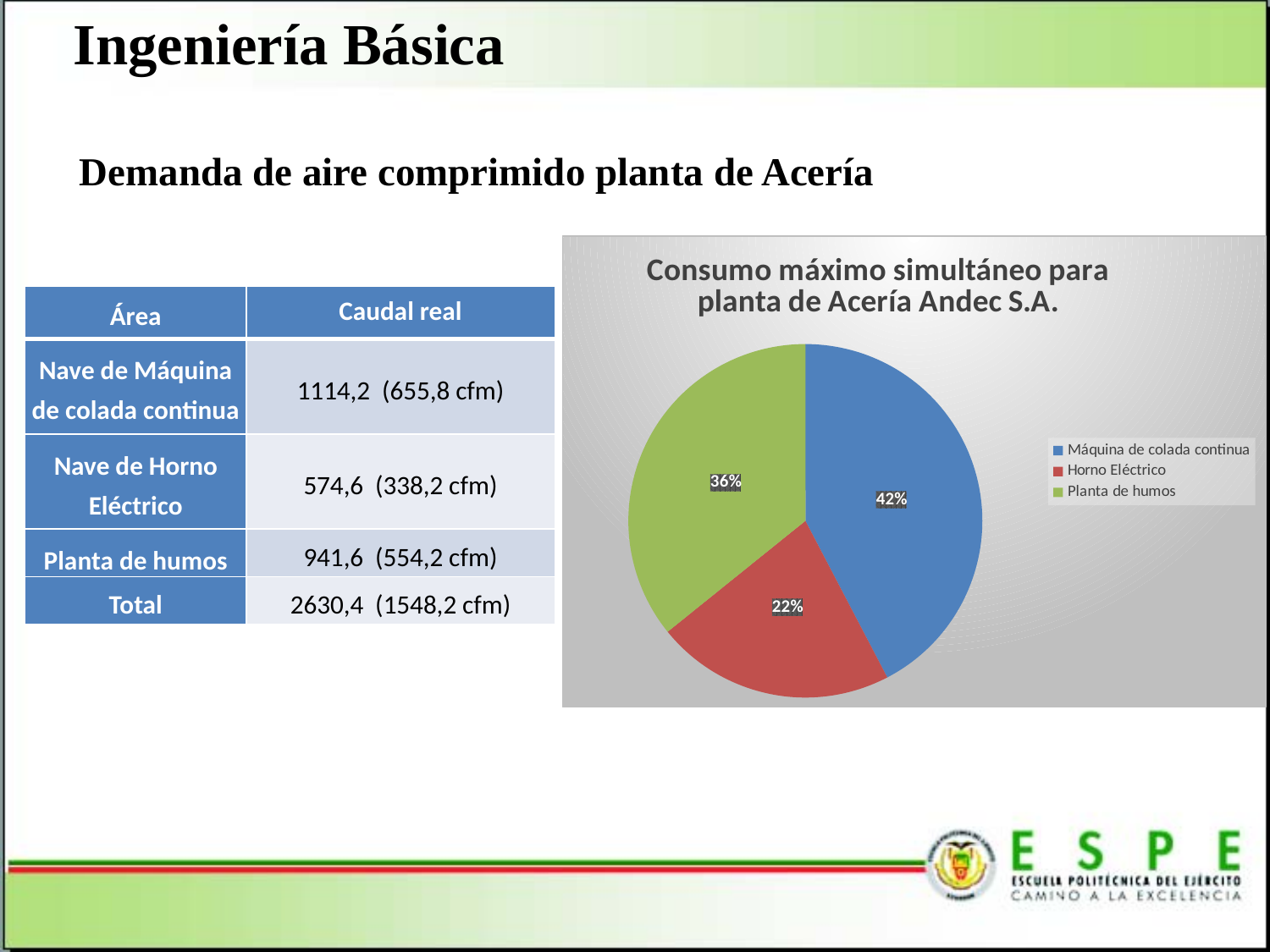
What share of the pie does Planta de humos represent? 36% What kind of chart is shown on the slide? pie chart What is the title of the chart? Consumo máximo simultáneo para planta de Acería Andec S.A. How many slices does the pie chart have? 3 What share of the pie does Horno Eléctrico represent? 22% Which category has the smallest slice of the pie? Horno Eléctrico Which slice is larger, Planta de humos or Horno Eléctrico? Planta de humos What colour is the Planta de humos slice? green Which category has the largest slice of the pie? Máquina de colada continua What share of the pie does Máquina de colada continua represent? 42% What is the difference in percentage points between the Máquina de colada continua slice and the Horno Eléctrico slice? 20% How many entries does the legend list? 3